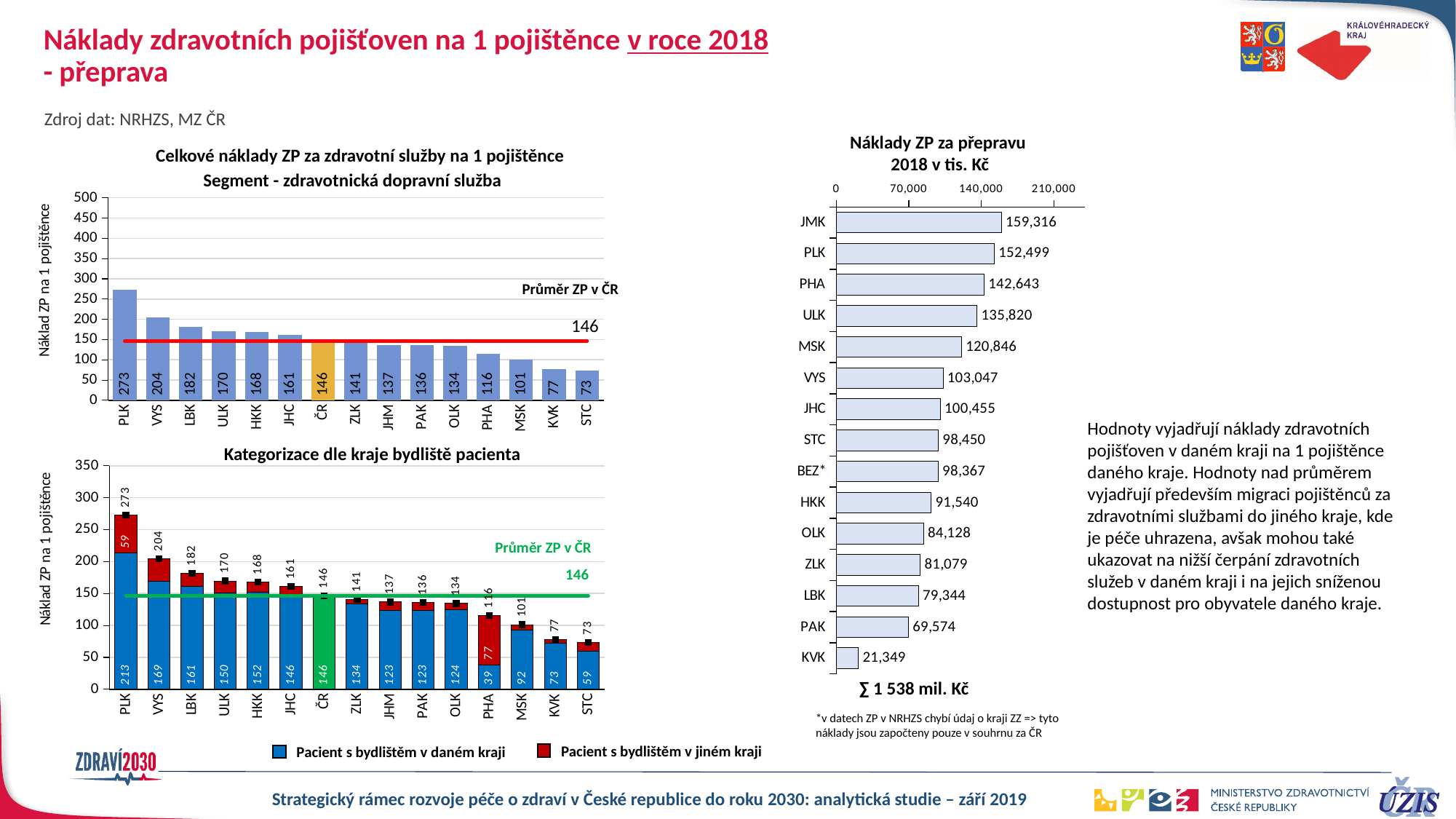
In the chart 'Náklady ZP za přepravu 2018 v tis. Kč', what is the value for JMK? 159,316 In the chart 'Náklady ZP za přepravu 2018 v tis. Kč', which region has the lowest value? KVK In the chart 'Celkové náklady ZP za zdravotní služby na 1 pojištěnce', which region has the highest value? PLK In the chart 'Kategorizace dle kraje bydliště pacienta', what is the total of the stacked bar for PHA? 116 How many bars are shown in the chart 'Celkové náklady ZP za zdravotní služby na 1 pojištěnce'? 15 In the chart 'Kategorizace dle kraje bydliště pacienta', what is the value of 'Pacient s bydlištěm v daném kraji' for PHA? 39 In the chart 'Celkové náklady ZP za zdravotní služby na 1 pojištěnce', which region has the lowest value? STC In the chart 'Celkové náklady ZP za zdravotní služby na 1 pojištěnce', what is the difference between the values for PLK and VYS? 69 In the chart 'Celkové náklady ZP za zdravotní služby na 1 pojištěnce', what is the value for PLK? 273 How many series does the legend of the chart 'Kategorizace dle kraje bydliště pacienta' list? 2 In the chart 'Kategorizace dle kraje bydliště pacienta', what is the value of 'Pacient s bydlištěm v jiném kraji' for PLK? 59 What kind of chart is 'Náklady ZP za přepravu 2018 v tis. Kč'? bar chart